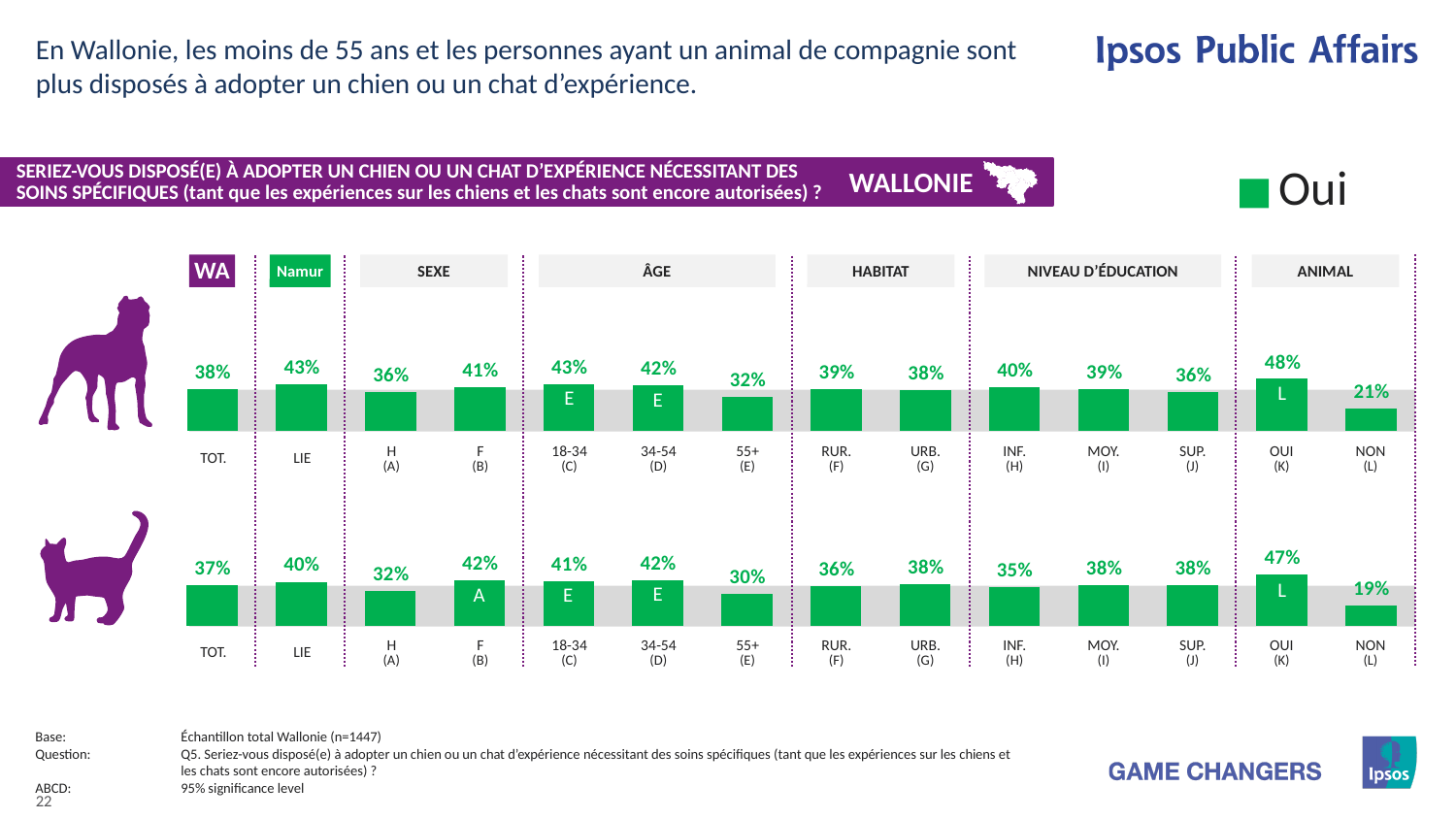
In the top (dog) chart, what is the difference between the OUI (K) and NON (L) values under ANIMAL? 27 percentage points In the bottom (cat) chart, which category has the lowest value? NON (L) How many bars are shown in the top (dog) chart? 14 In the bottom (cat) chart, what is the value for the 55+ age group? 30% What single legend entry is shown on the slide? Oui In the top (dog) chart, do the values fall from the 18-34 group to the 55+ group? Yes, they fall In the top (dog) chart, which category has the highest value? OUI (K) In the top (dog) chart, what is the value for Namur (LIE)? 43% In the bottom (cat) chart, which is larger: the value for H (A) or F (B)? F (B) In the bottom (cat) chart, what is the difference between the 18-34 and 55+ values? 11 percentage points What kind of chart is used on this slide? Bar chart In the top (dog) chart, what is the value for TOT.? 38%